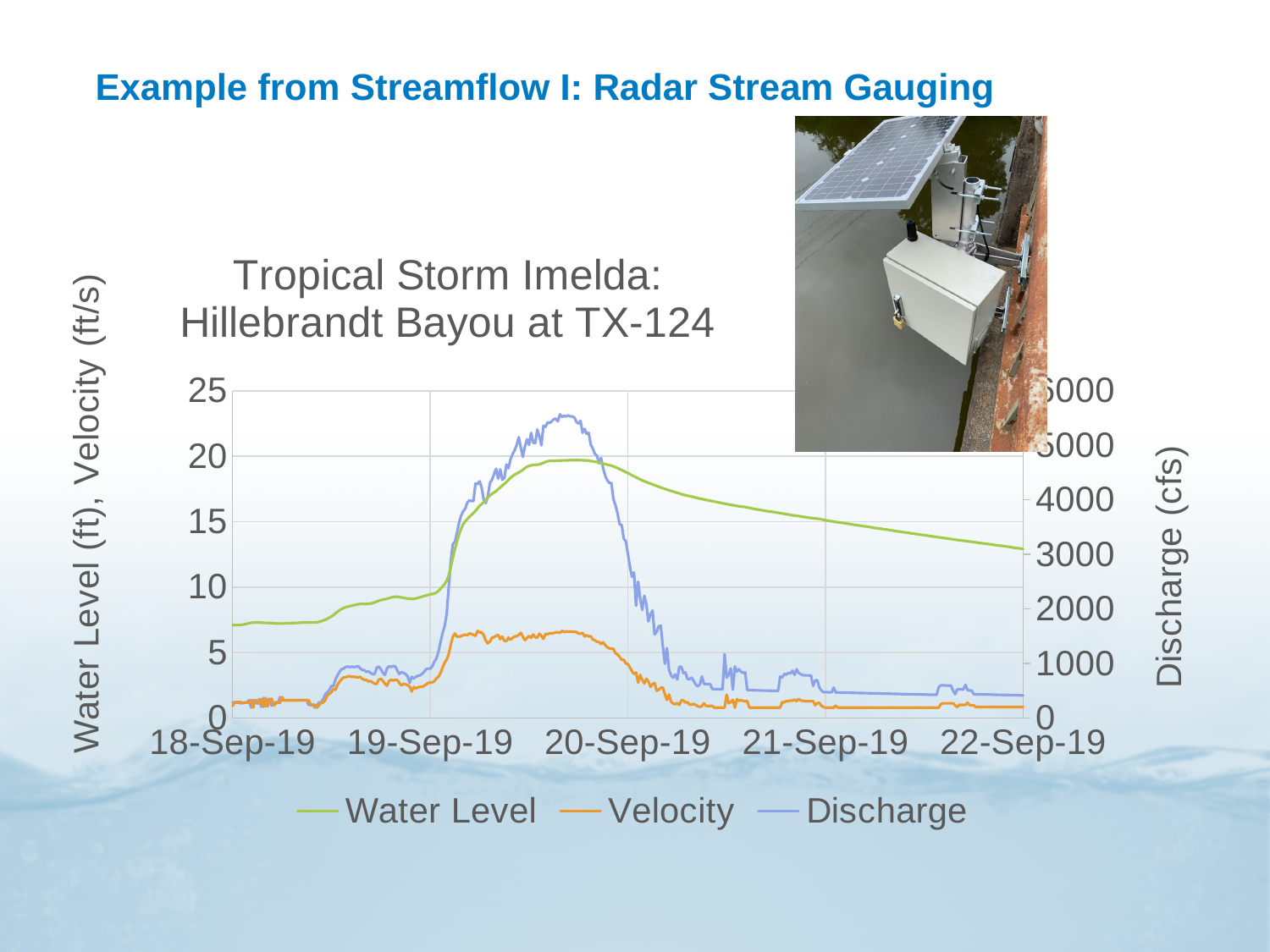
What is the title of the chart? Tropical Storm Imelda: Hillebrandt Bayou at TX-124 What kind of chart is shown on the slide? Line chart What is the label of the right-hand vertical axis? Discharge (cfs) Is the Water Level value at 18-Sep-19 greater or less than 10? less Is the peak Velocity value greater or less than 5? greater How many series does the chart legend list? 3 Does the Water Level rise or fall between 18-Sep-19 and 19-Sep-19? rise Is the Water Level value at 18-Sep-19 greater or less than 5? greater Does the Water Level rise or fall between 20-Sep-19 and 22-Sep-19? fall